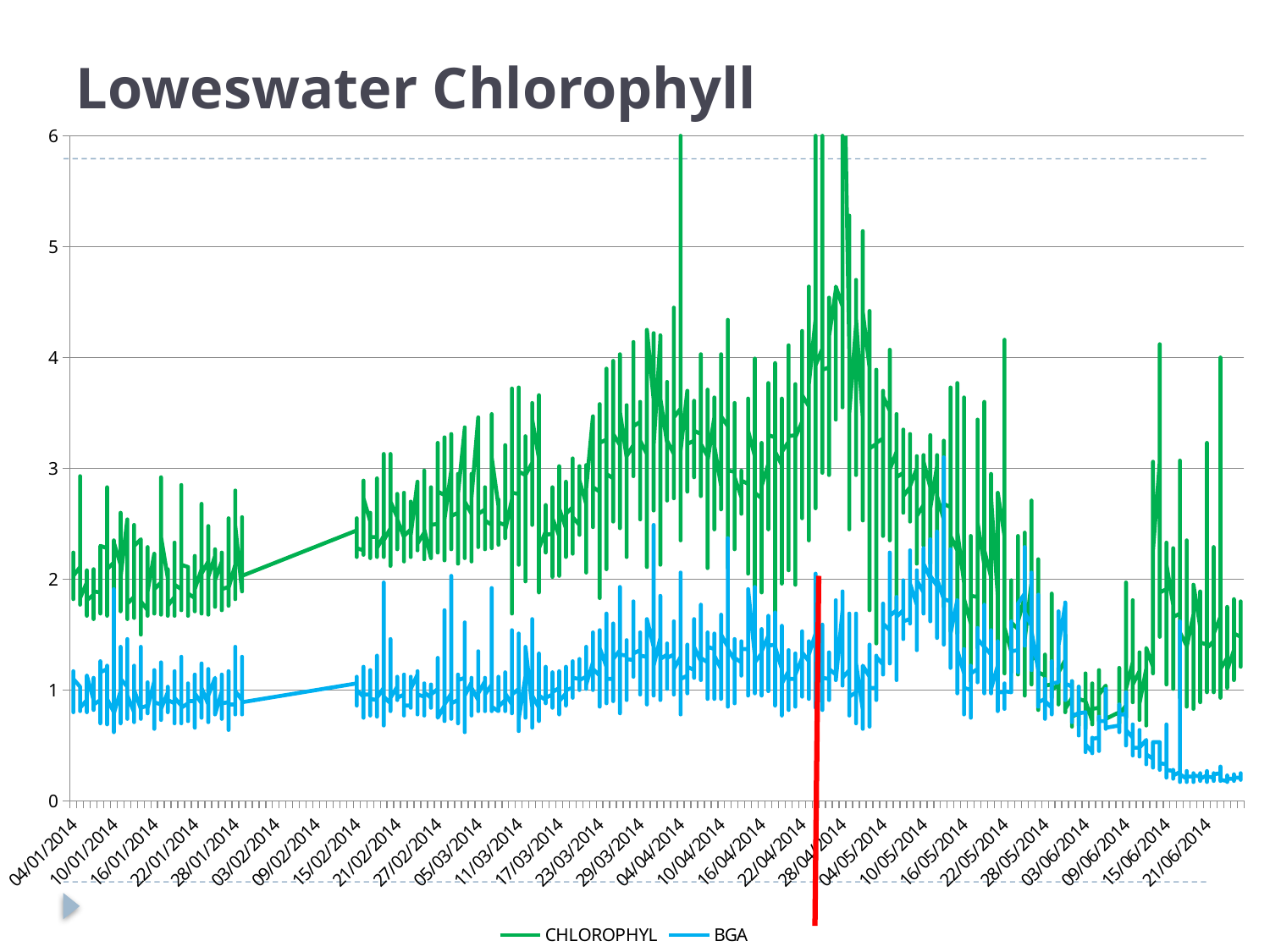
How many series does the legend list? 2 Is the BGA value around 28/04/2014 greater or less than 3? less Which series has the higher values around 04/01/2014, CHLOROPHYL or BGA? CHLOROPHYL What kind of chart is shown on the slide? line chart Which series reaches the highest value on the chart? CHLOROPHYL What is the title of the chart? Loweswater Chlorophyll What are the two series named in the legend? CHLOROPHYL and BGA Does the BGA series rise or fall between 16/05/2014 and 21/06/2014? fall Is the highest CHLOROPHYL value on the chart greater or less than 5? greater Is the BGA value at 21/06/2014 greater or less than 1? less Does the CHLOROPHYL series generally rise or fall between 04/01/2014 and 04/04/2014? rise